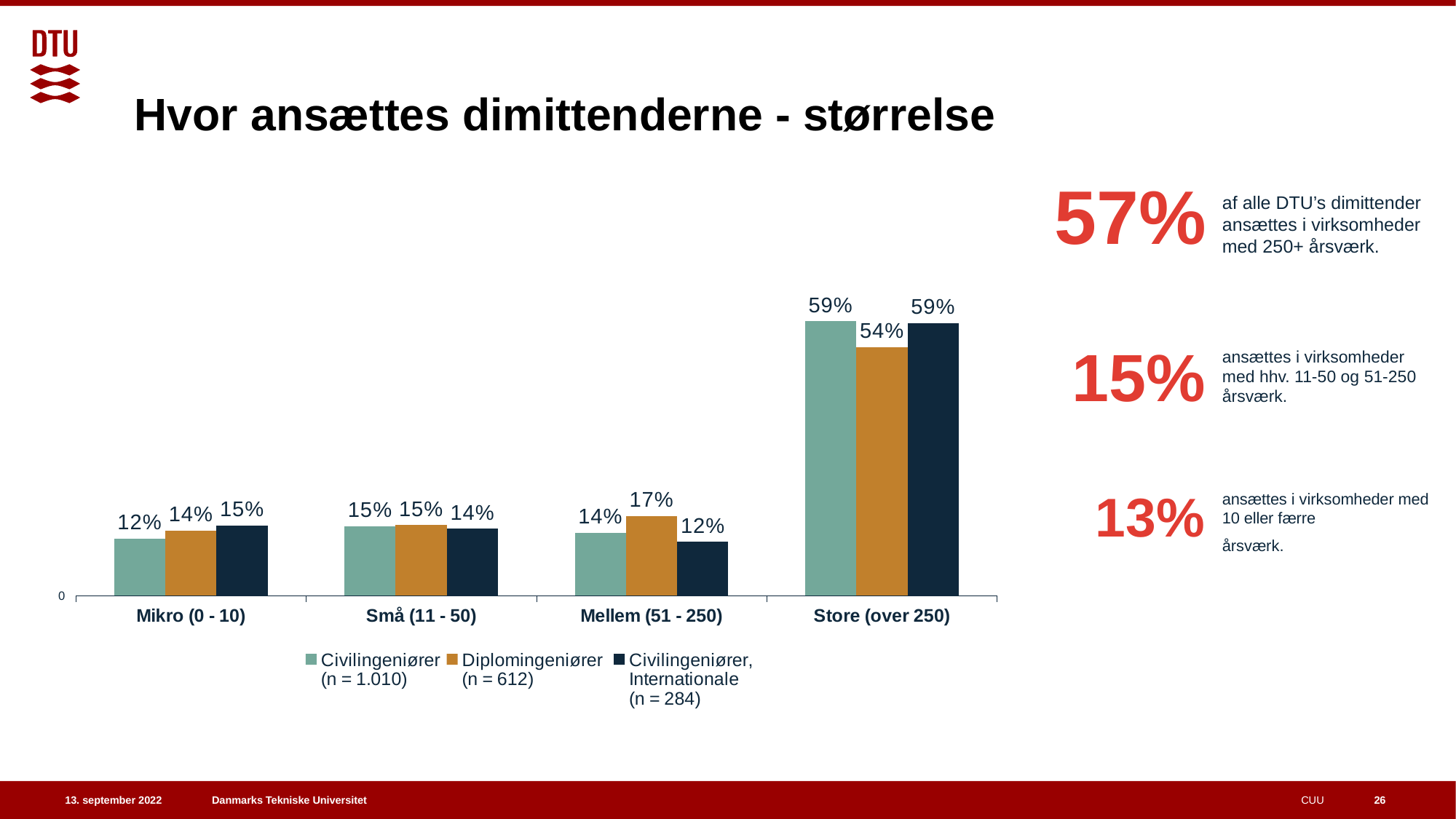
What sample size (n) is given in the legend for Civilingeniører, Internationale? n = 284 In the Mellem (51 - 250) category, which series has the larger value: Diplomingeniører or Civilingeniører, Internationale? Diplomingeniører How many series does the legend list? 3 What is the difference between the Civilingeniører and Diplomingeniører values in the Store (over 250) category? 5% What is the value for Civilingeniører, Internationale in the Mellem (51 - 250) category? 12% How many categories are shown on the x axis? 4 Which category has the lowest value for Civilingeniører? Mikro (0 - 10) What is the value for Civilingeniører in the Mikro (0 - 10) category? 12% What kind of chart is shown on the slide? Bar chart What is the value for Diplomingeniører in the Mellem (51 - 250) category? 17% What is the value for Diplomingeniører in the Store (over 250) category? 54% Which category has the highest value for Diplomingeniører? Store (over 250)